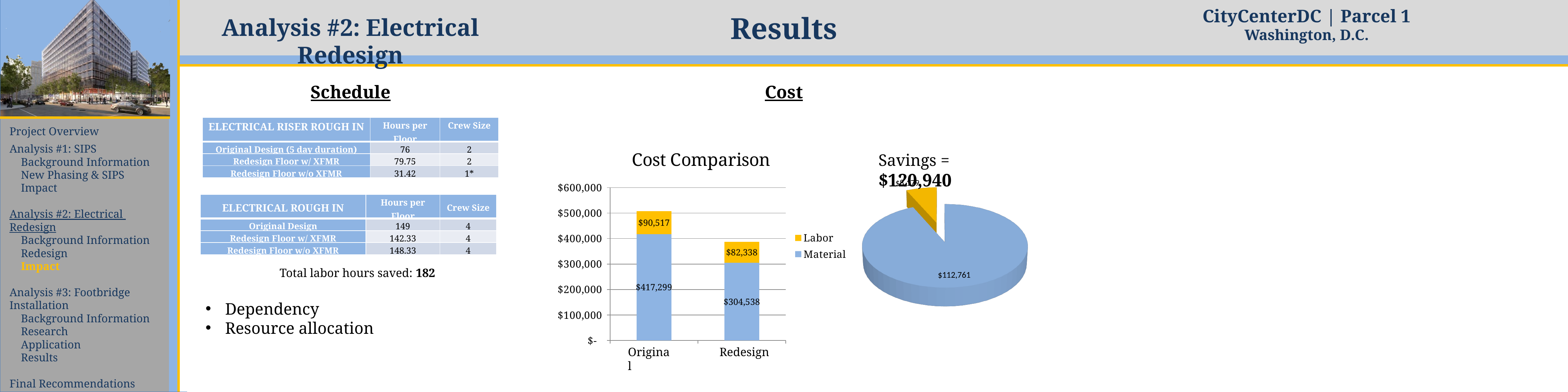
In the Cost Comparison chart, which colour represents Labor? Gold/yellow In the Cost Comparison chart, how many series does the legend list? 2 In the pie chart on the right, what value is printed on the large blue slice? $112,761 In the Cost Comparison chart, what is the total of the stacked bar for Original? $507,816 In the Cost Comparison chart, what is the total of the stacked bar for Redesign? $386,876 In the Cost Comparison chart, which category has the larger Labor value, Original or Redesign? Original In the Cost Comparison chart, what is the difference between the Material values for Original and Redesign? $112,761 In the Cost Comparison chart, what is the Labor value for Redesign? $82,338 In the Cost Comparison chart, what is the Material value for Original? $417,299 In the Cost Comparison chart, what is the Labor value for Original? $90,517 In the Cost Comparison chart, what is the Material value for Redesign? $304,538 What kind of chart is the Cost Comparison chart? Stacked bar chart